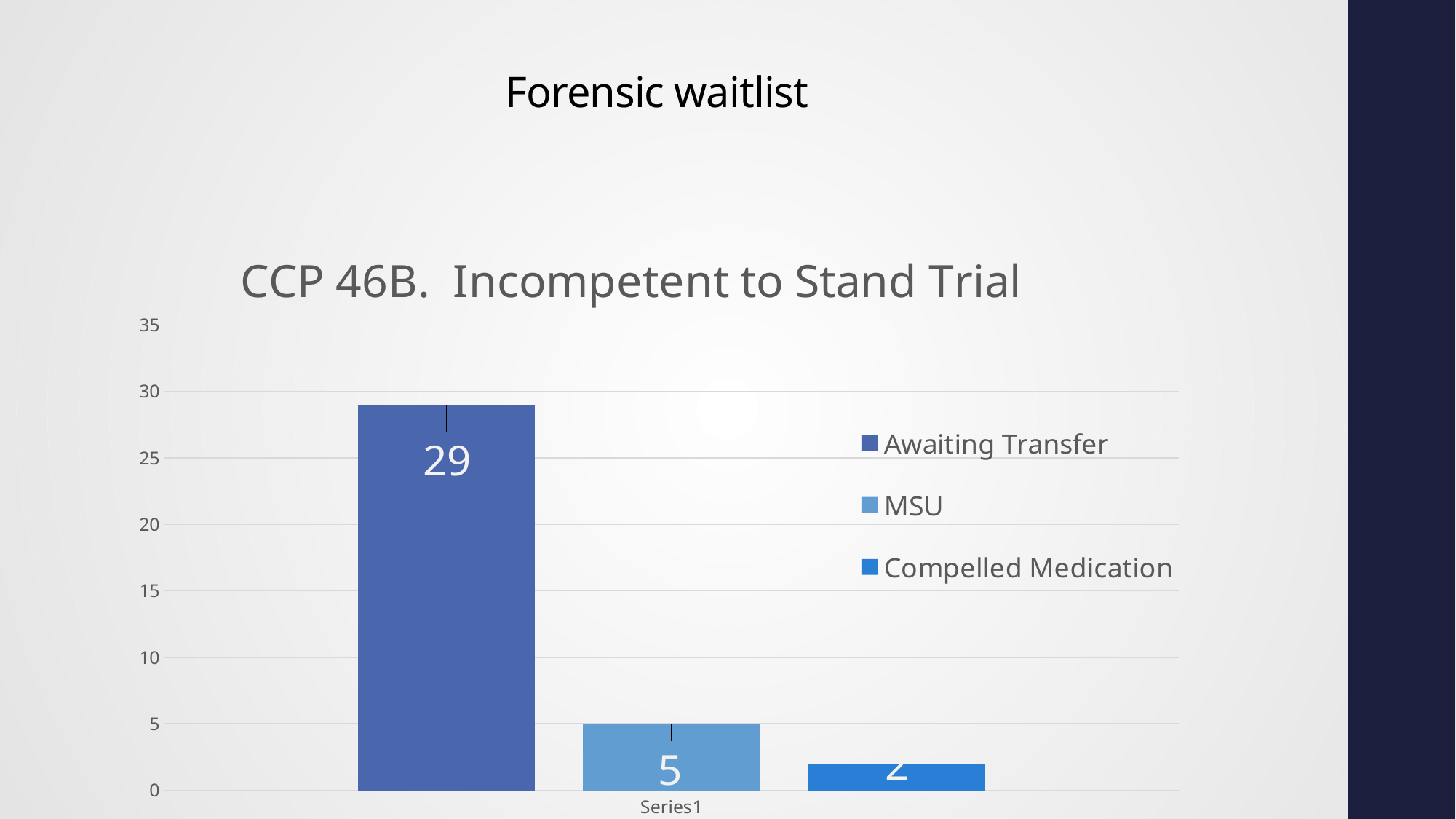
Which series has the lowest value? Compelled Medication What is the value for Compelled Medication? 2 Which is larger, the value for MSU or the value for Compelled Medication? MSU What is the difference between the Awaiting Transfer value and the MSU value? 24 What is the value for Awaiting Transfer? 29 What kind of chart is shown on the slide? Bar chart Is the value for Awaiting Transfer greater or less than 25? greater What is the title of the chart? CCP 46B. Incompetent to Stand Trial How many series does the legend list? 3 Which series has the highest value? Awaiting Transfer What is the value for MSU? 5 What is the total of the three values shown in the chart? 36